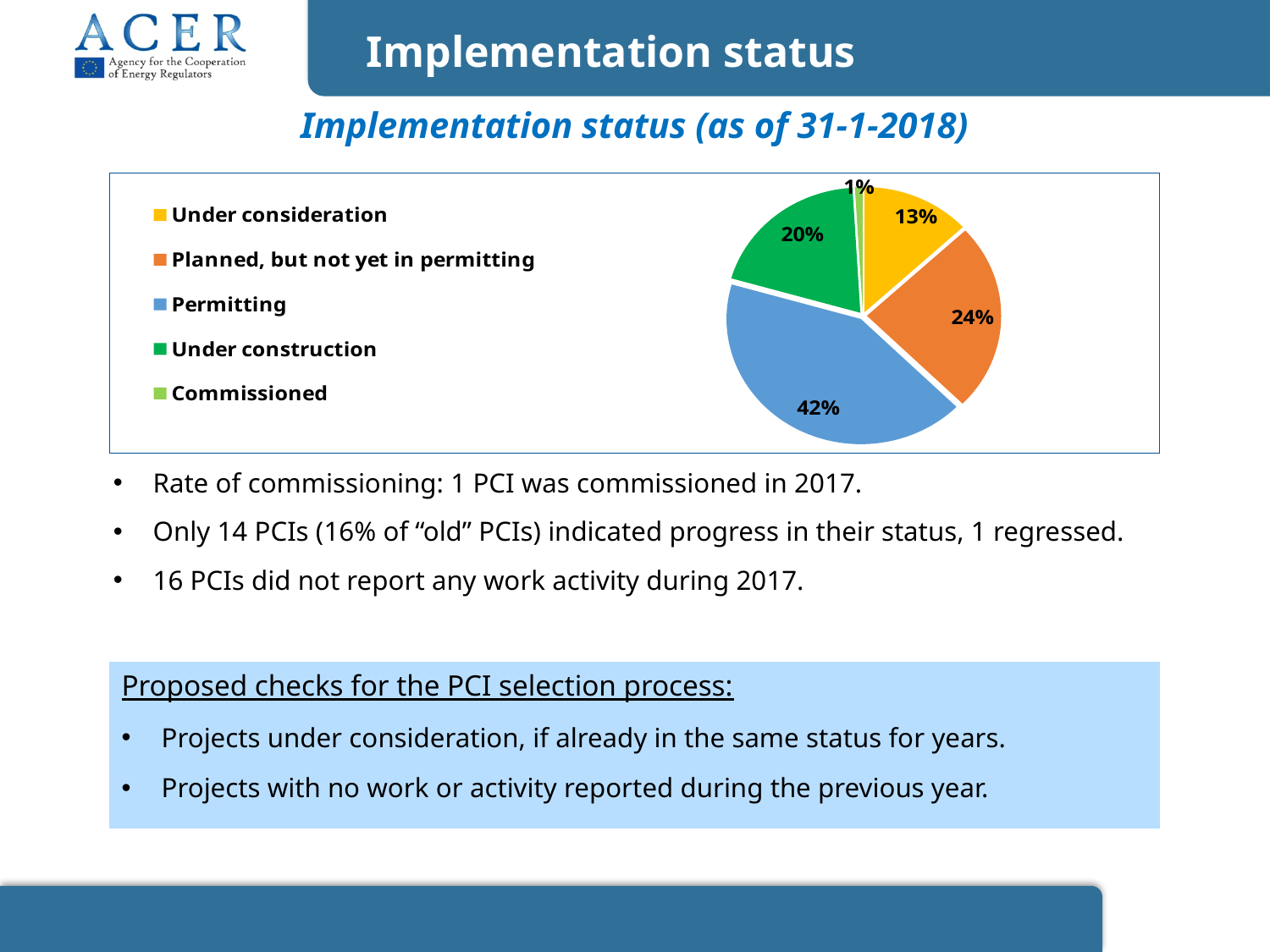
What is the difference in percentage points between Permitting and Planned, but not yet in permitting? 18 Which category has the smallest slice of the pie? Commissioned What kind of chart is shown on the slide? pie chart How many categories does the pie chart show? 5 What share of the pie is Commissioned? 1% What share of the pie is Permitting? 42% Which is larger, the share for Under construction or the share for Under consideration? Under construction What share of the pie is Under consideration? 13% What colour is the Permitting slice in the pie chart? blue Which category has the largest slice of the pie? Permitting